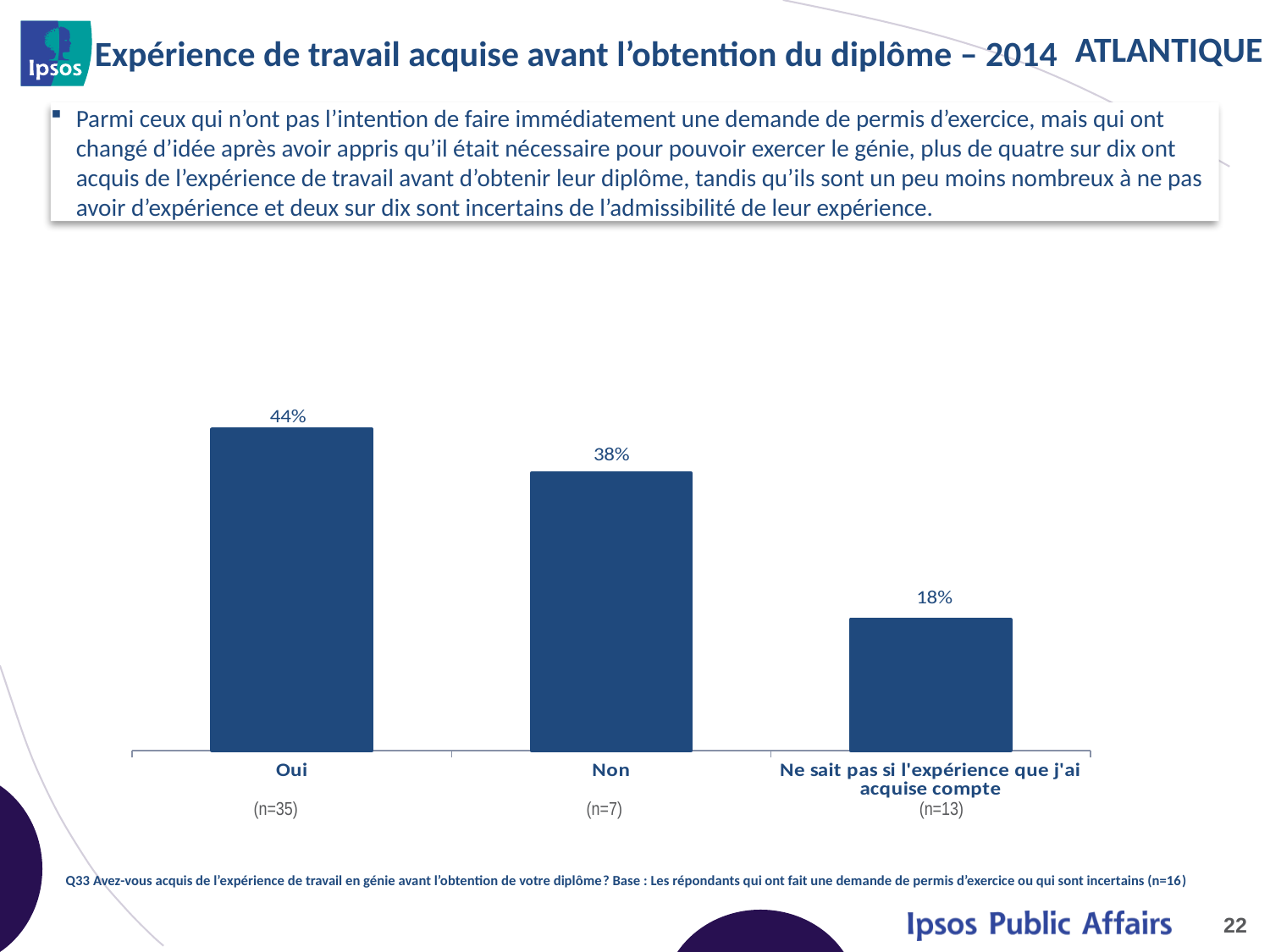
How many categories are shown in the chart? 3 What is the difference between the values for "Oui" and "Non"? 6% Which category has the lowest value? Ne sait pas si l'expérience que j'ai acquise compte Which category has the highest value? Oui What is the value for "Non"? 38% What is the value for "Oui"? 44% What is the sample size (n) shown under the "Oui" category? n=35 Do the values rise or fall from left to right across the categories? Fall What is the value for "Ne sait pas si l'expérience que j'ai acquise compte"? 18% What is the difference between the values for "Non" and "Ne sait pas si l'expérience que j'ai acquise compte"? 20% Which is larger, the value for "Oui" or the value for "Non"? Oui What kind of chart is shown on the slide? Bar chart